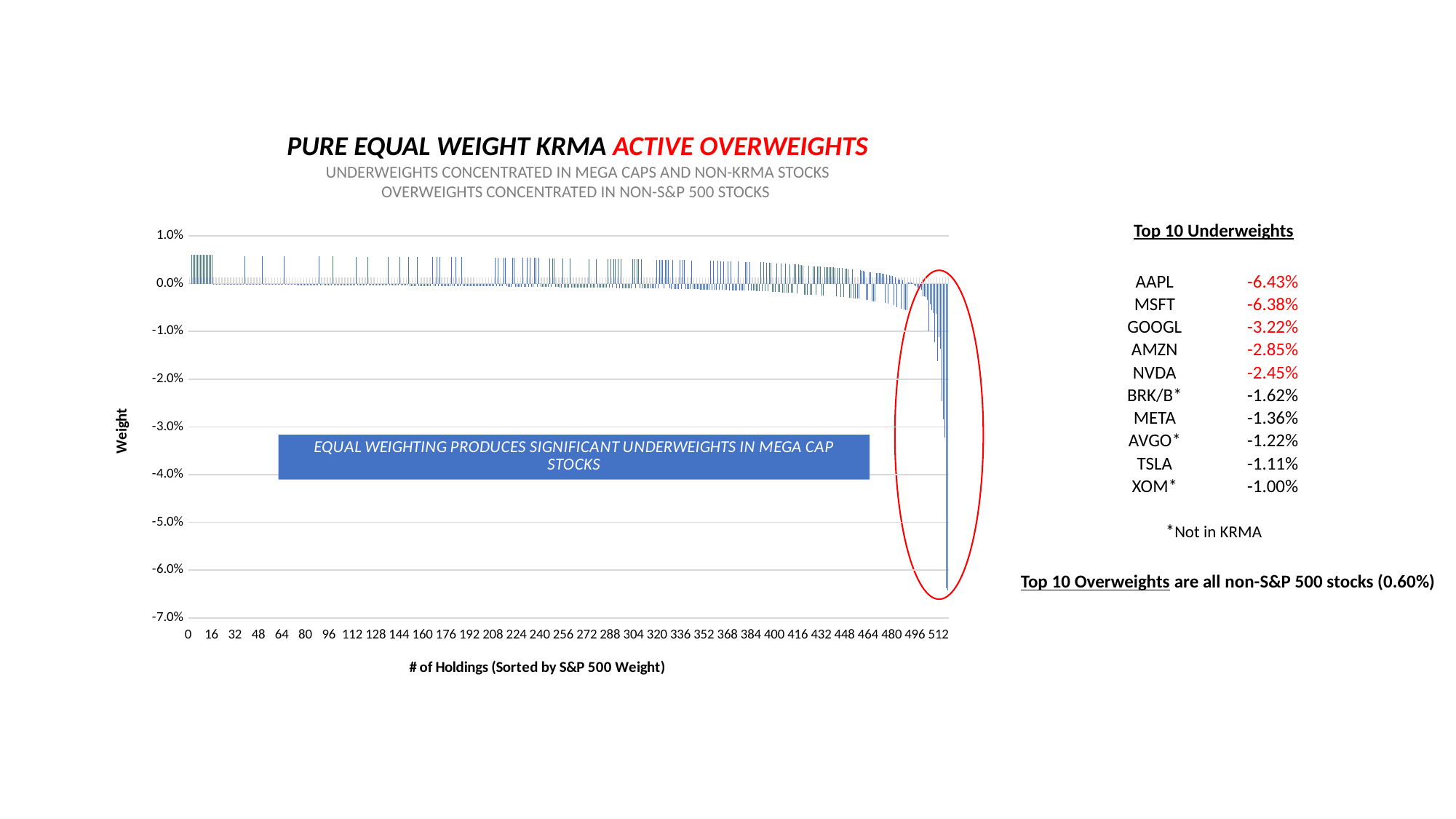
According to the Top 10 Underweights list, what is the difference between the weights of AAPL and MSFT? 0.05% Is the lowest bar on the chart greater or less than -6.0%? less What is the label of the vertical axis of the chart? Weight What is the title of the chart on the slide? PURE EQUAL WEIGHT KRMA ACTIVE OVERWEIGHTS According to the Top 10 Underweights list on the slide, what is the weight for NVDA? -2.45% According to the Top 10 Underweights list on the slide, what is the weight for AAPL? -6.43% According to the Top 10 Underweights list, which stock has the largest underweight? AAPL Do the bar values generally rise or fall moving from left to right along the x axis? fall According to the Top 10 Underweights list, which has the larger underweight, GOOGL or AMZN? GOOGL What is the lowest value shown on the vertical axis of the chart? -7.0% What kind of chart is shown on the slide? Bar chart Is the highest bar on the chart greater or less than 1.0%? less